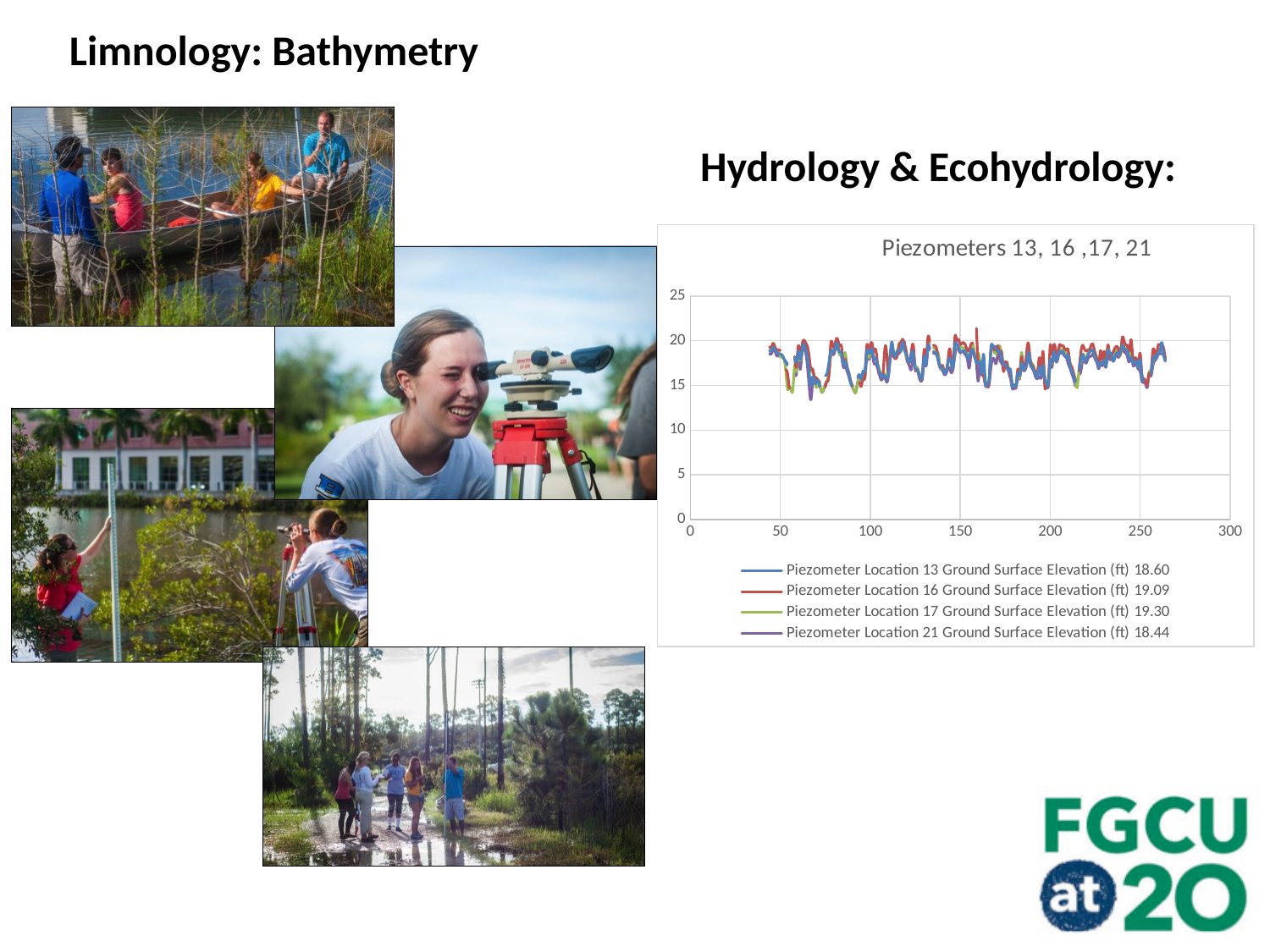
What ground surface elevation is listed in the legend for Piezometer Location 16? 19.09 What is the highest value shown on the x axis of the Piezometers chart? 300 Are the plotted values for Piezometer Location 13 greater or less than 10? greater How many series does the legend of the Piezometers chart list? 4 What is the title of the chart on the slide? Piezometers 13, 16 ,17, 21 What kind of chart is shown under the heading Hydrology & Ecohydrology? line chart Are the plotted values for Piezometer Location 16 greater or less than 25? less Are the plotted values for Piezometer Location 21 greater or less than 5? greater